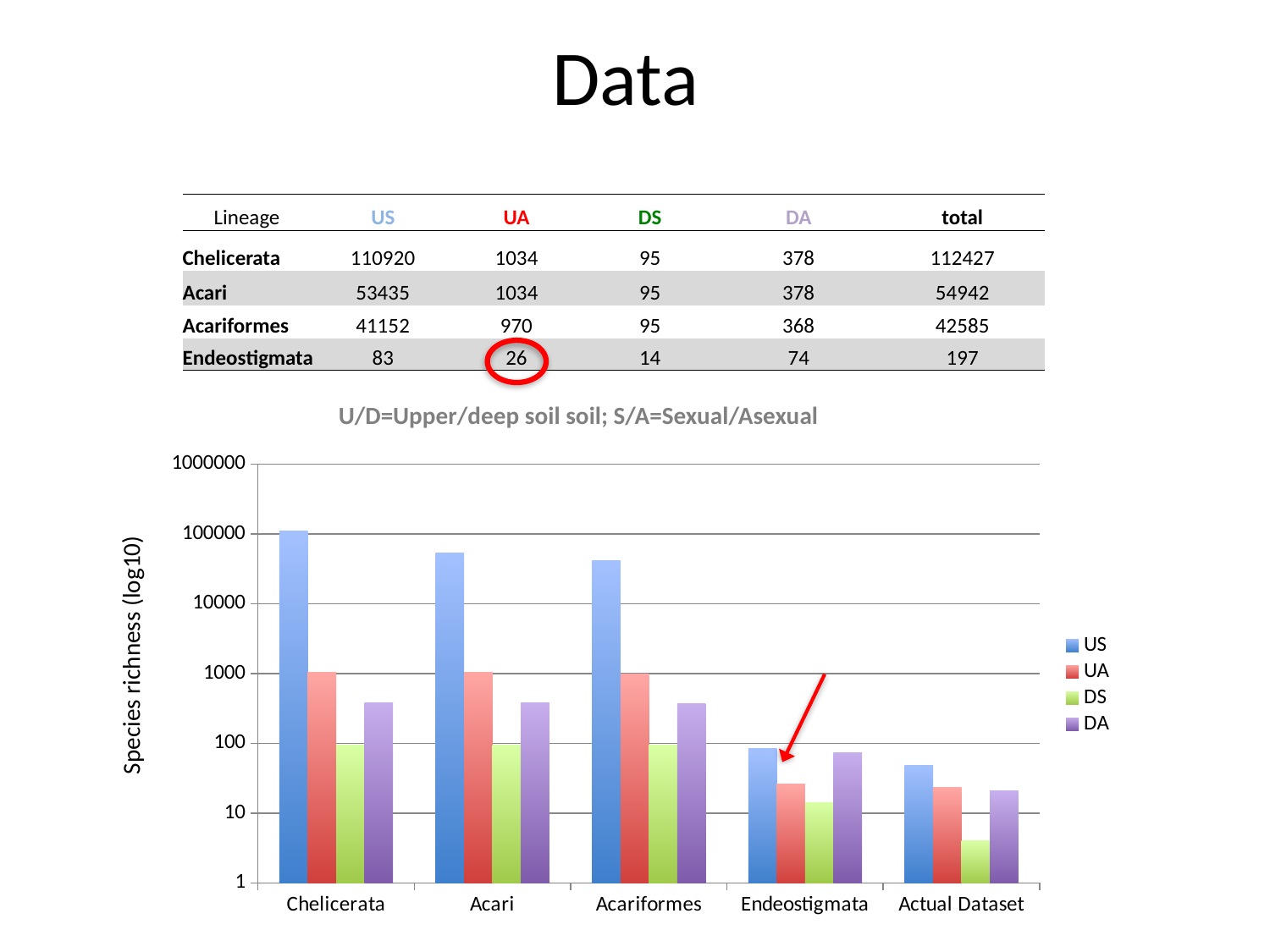
What is the label on the y axis of the chart? Species richness (log10) Which category has the highest US bar in the chart? Chelicerata Is the DS value for Actual Dataset greater or less than 10? less Using the values printed in the table, what is the difference between the US value for Chelicerata and the US value for Acari? 57485 Which category has the lowest DS bar in the chart? Actual Dataset How many series does the chart legend list? 4 What is the UA value for Endeostigmata, as printed in the table above the chart? 26 How many categories are shown along the x axis of the chart? 5 What kind of chart is shown on the slide? bar chart For Endeostigmata, which is larger, the UA value or the DA value? DA Is the US value for Actual Dataset greater or less than 100? less Do the US values rise or fall moving from left to right along the x axis? fall